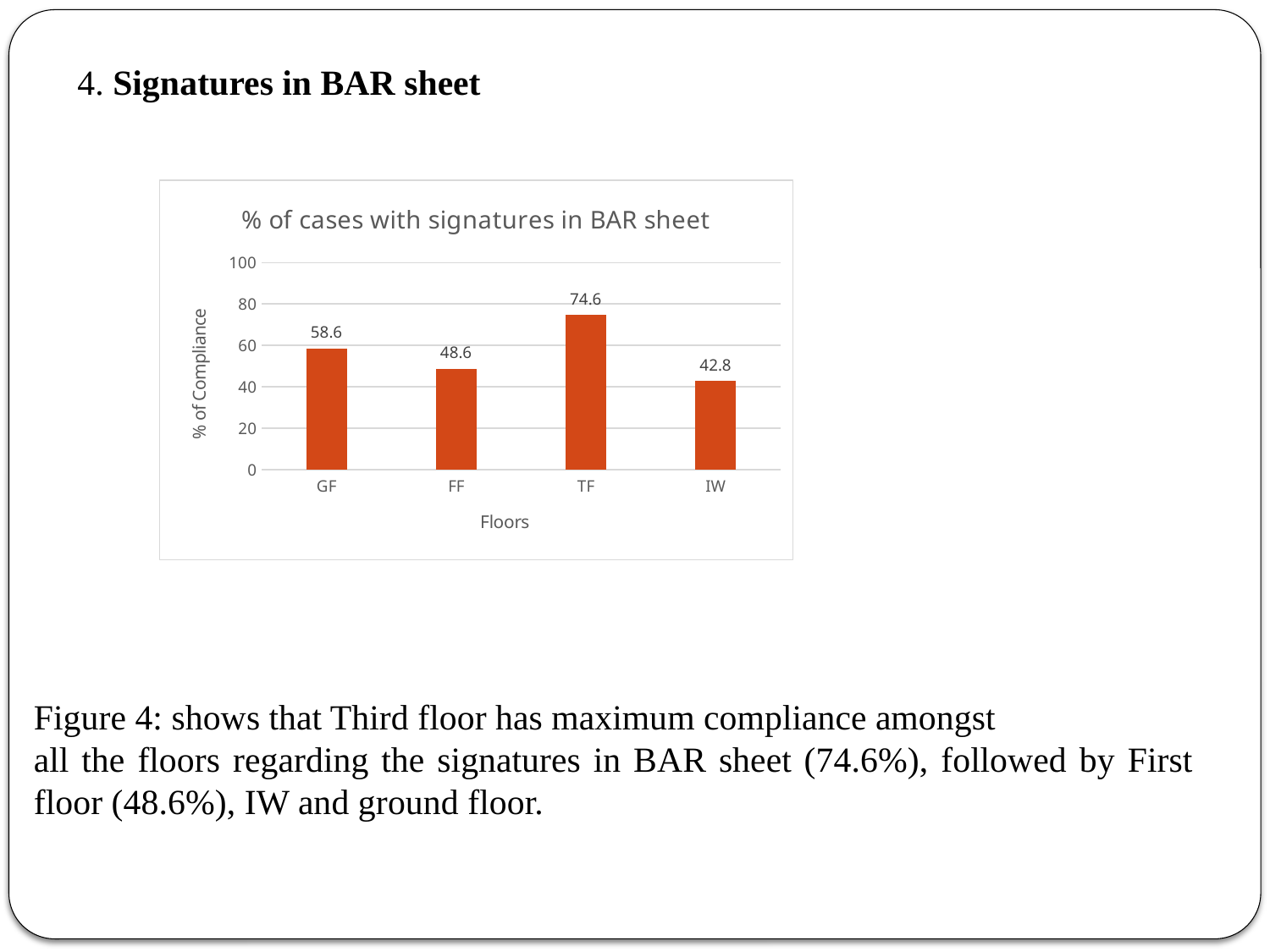
What is the value for IW in the chart? 42.8 What is the difference between the values for TF and FF? 26 Which is larger, the value for GF or the value for FF? GF What is the value for TF in the chart? 74.6 Which floor has the highest % of compliance? TF What is the difference between the values for GF and IW? 15.8 Which floor has the lowest % of compliance? IW What is the value for GF in the chart? 58.6 Is the value for TF greater or less than 60? greater What is the title of the chart? % of cases with signatures in BAR sheet What kind of chart is shown on the slide? bar chart How many floors are shown on the x axis of the chart? 4